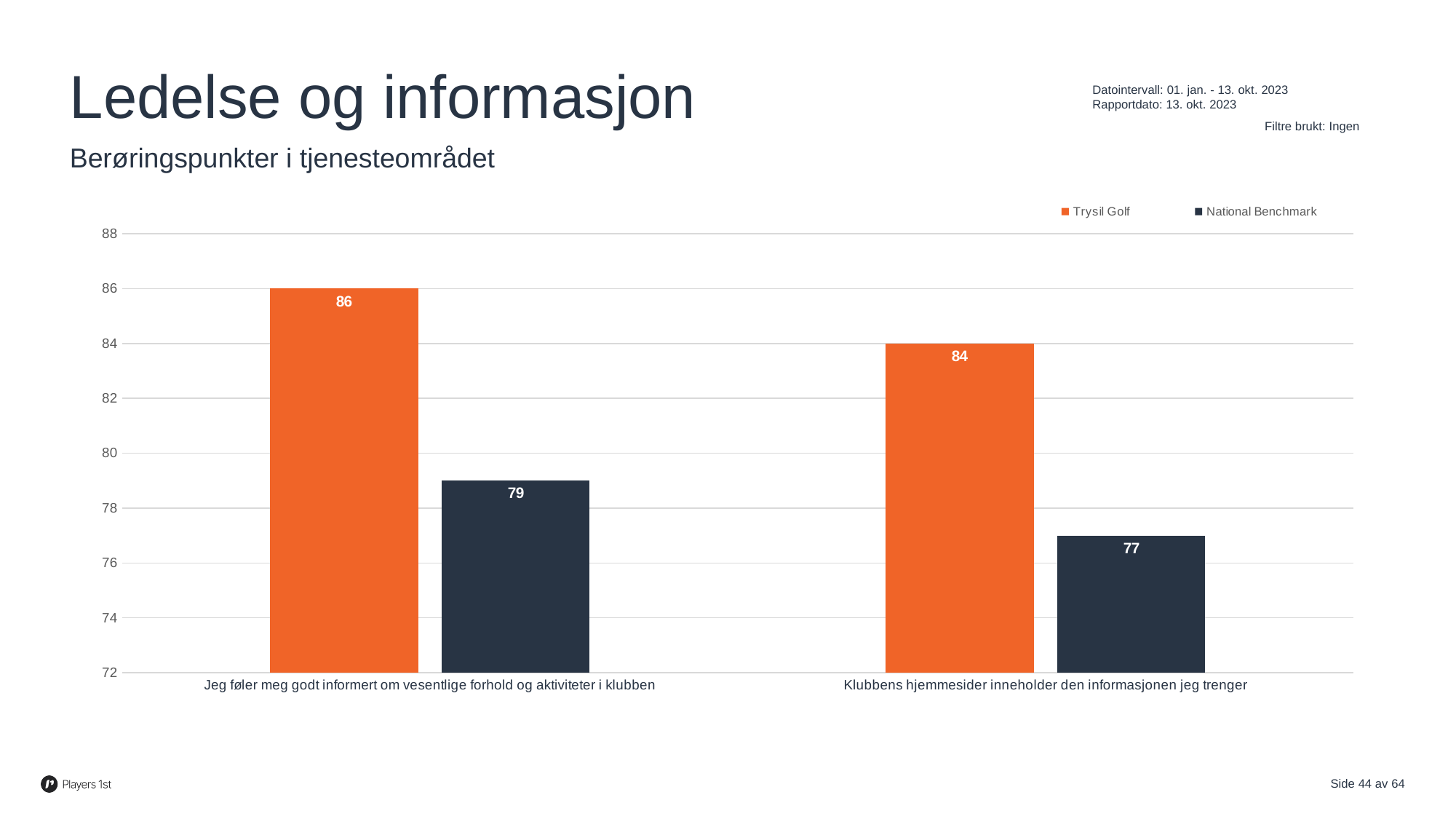
Which category has the lowest National Benchmark value? Klubbens hjemmesider inneholder den informasjonen jeg trenger How many categories are shown on the x axis? 2 What kind of chart is shown on the slide? Bar chart What is the difference between the Trysil Golf and National Benchmark values for "Klubbens hjemmesider inneholder den informasjonen jeg trenger"? 7 What is the Trysil Golf value for "Klubbens hjemmesider inneholder den informasjonen jeg trenger"? 84 What is the difference between the Trysil Golf and National Benchmark values for "Jeg føler meg godt informert om vesentlige forhold og aktiviteter i klubben"? 7 Which category has the highest Trysil Golf value? Jeg føler meg godt informert om vesentlige forhold og aktiviteter i klubben What is the Trysil Golf value for "Jeg føler meg godt informert om vesentlige forhold og aktiviteter i klubben"? 86 What is the National Benchmark value for "Klubbens hjemmesider inneholder den informasjonen jeg trenger"? 77 Which is larger for "Klubbens hjemmesider inneholder den informasjonen jeg trenger": Trysil Golf or National Benchmark? Trysil Golf What is the National Benchmark value for "Jeg føler meg godt informert om vesentlige forhold og aktiviteter i klubben"? 79 How many series does the legend list? 2